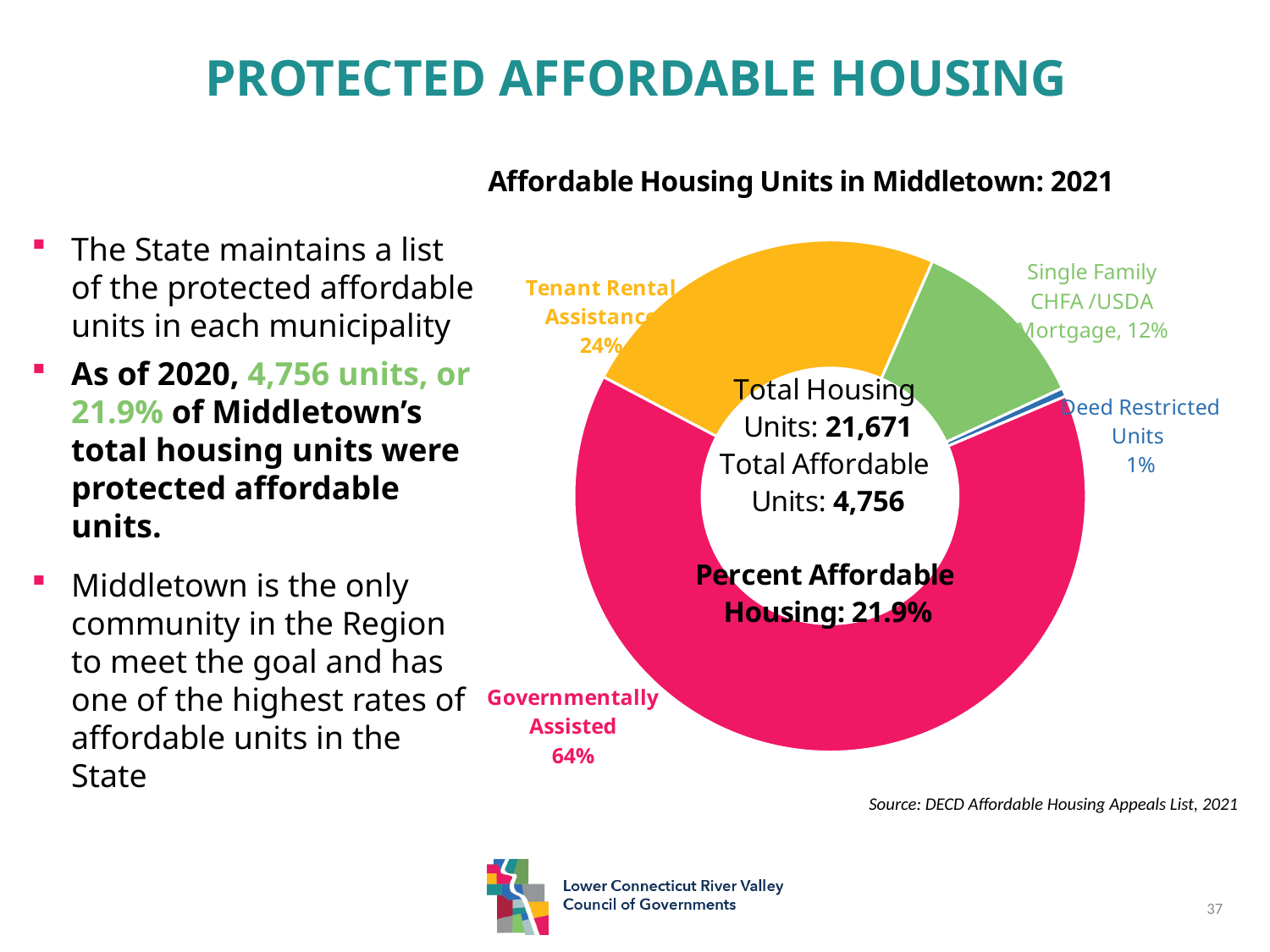
Which is larger, the share for Tenant Rental Assistance or the share for Single Family CHFA/USDA Mortgage? Tenant Rental Assistance What share of affordable housing units is Tenant Rental Assistance? 24% Which category has the largest share of the chart? Governmentally Assisted What type of chart is shown on the slide? Pie chart (donut) What share of affordable housing units is Deed Restricted Units? 1% Which category has the smallest share of the chart? Deed Restricted Units What share of affordable housing units is Governmentally Assisted? 64% How many categories are shown in the chart? 4 What is the difference in percentage points between Governmentally Assisted and Tenant Rental Assistance? 40 percentage points What is the title of the chart? Affordable Housing Units in Middletown: 2021 According to the text in the centre of the chart, what is the total number of affordable units? 4,756